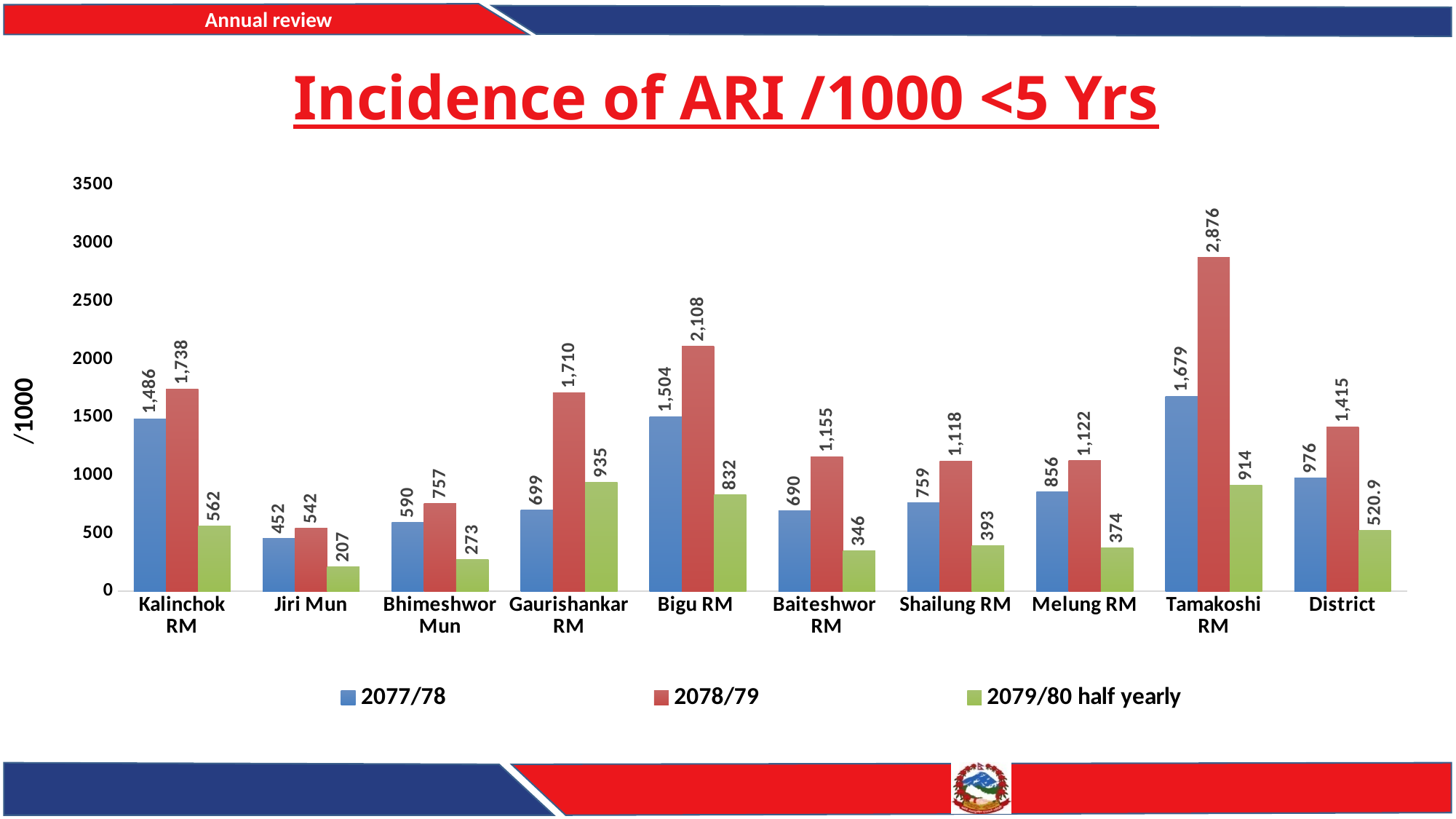
Is the 2078/79 value for Bigu RM greater or less than 2000? greater What is the value for Bigu RM in the 2077/78 series? 1,504 Which category has the highest value in the 2078/79 series? Tamakoshi RM How many series does the legend list? 3 What is the value for District in the 2079/80 half yearly series? 520.9 What kind of chart is shown on the slide? Bar chart What is the value for Tamakoshi RM in the 2078/79 series? 2,876 Which category has the lowest value in the 2079/80 half yearly series? Jiri Mun What is the difference between the 2078/79 and 2077/78 values for Kalinchok RM? 252 What is the title of the chart? Incidence of ARI /1000 <5 Yrs How many categories are shown on the x axis? 10 Which is larger for Gaurishankar RM: the 2077/78 value or the 2079/80 half yearly value? 2079/80 half yearly